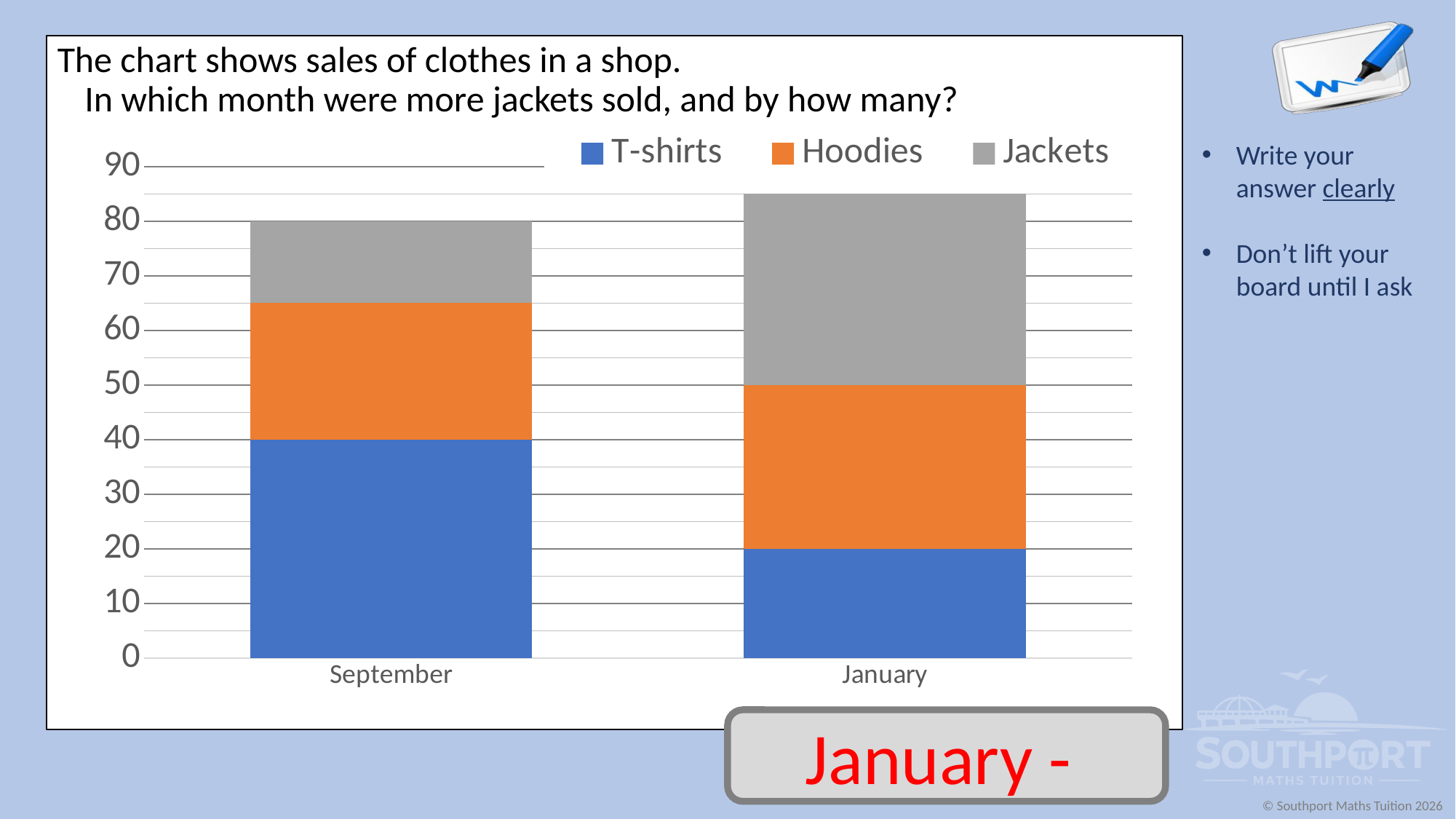
How many T-shirts were sold in January? 20 How many months are shown on the x axis? 2 How many series does the legend list? 3 How many T-shirts were sold in September? 40 In which month were more Jackets sold? January What type of chart is shown on the slide? stacked bar chart Is the total of the January bar greater or less than 80? greater Is the number of Jackets sold in September greater or less than 20? less What is the total height of the September bar? 80 How many Hoodies were sold in January? 30 Which colour represents Jackets in the legend? grey Is the number of Jackets sold in January greater or less than 30? greater